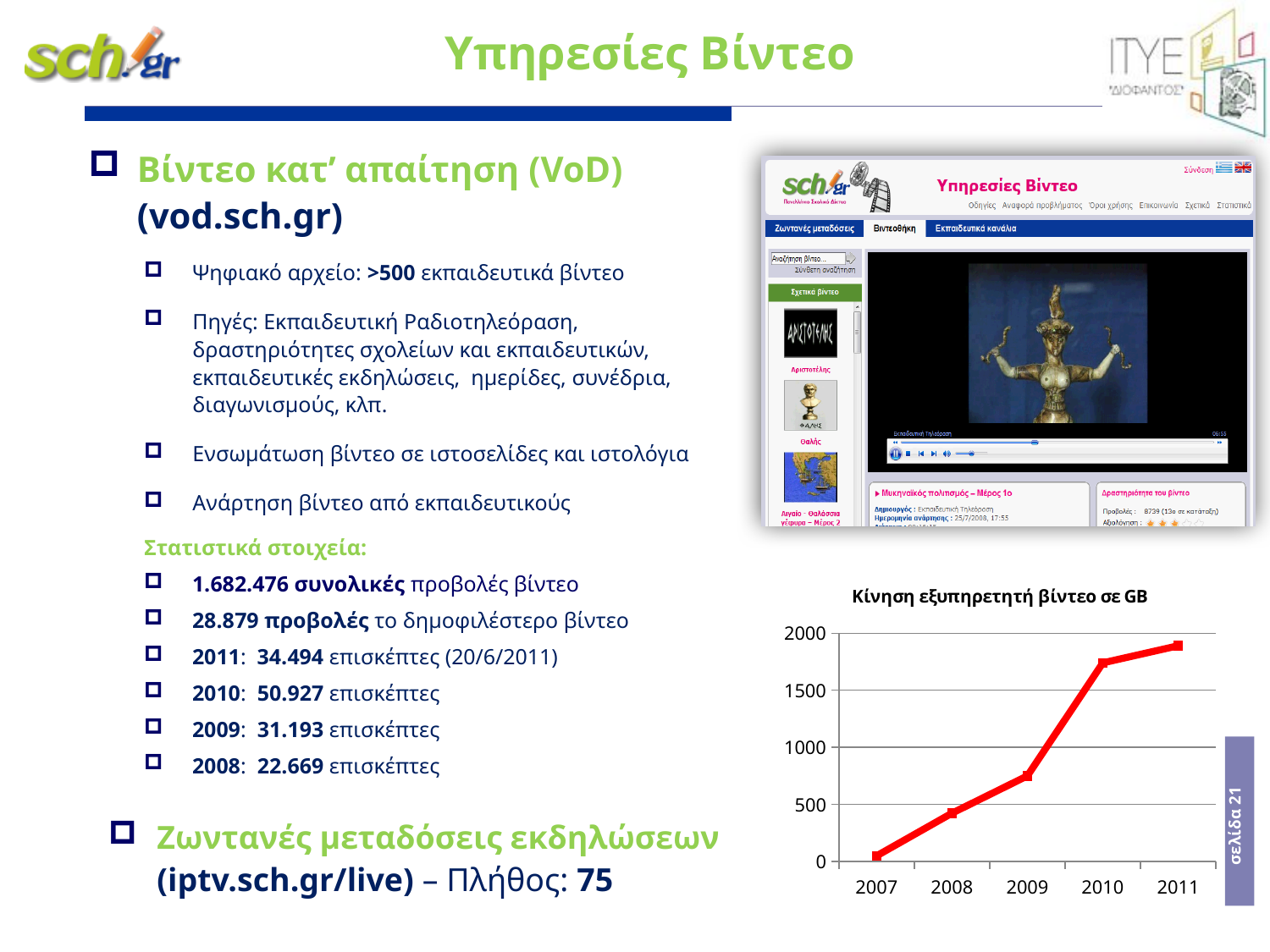
Which year has the lowest value in the chart? 2007 Is the value for 2007 greater or less than 500? less Do the values in the chart rise or fall from 2007 to 2011? rise What is the title of the chart on the slide? Κίνηση εξυπηρετητή βίντεο σε GB Which year has the highest value in the chart? 2011 Is the value for 2009 greater or less than 1000? less What kind of chart is shown under the title "Κίνηση εξυπηρετητή βίντεο σε GB"? line chart What is the highest tick value shown on the y axis of the chart? 2000 Is the value for 2010 greater or less than 1500? greater Which year has the larger value, 2009 or 2010? 2010 How many years are plotted on the x axis of the chart? 5